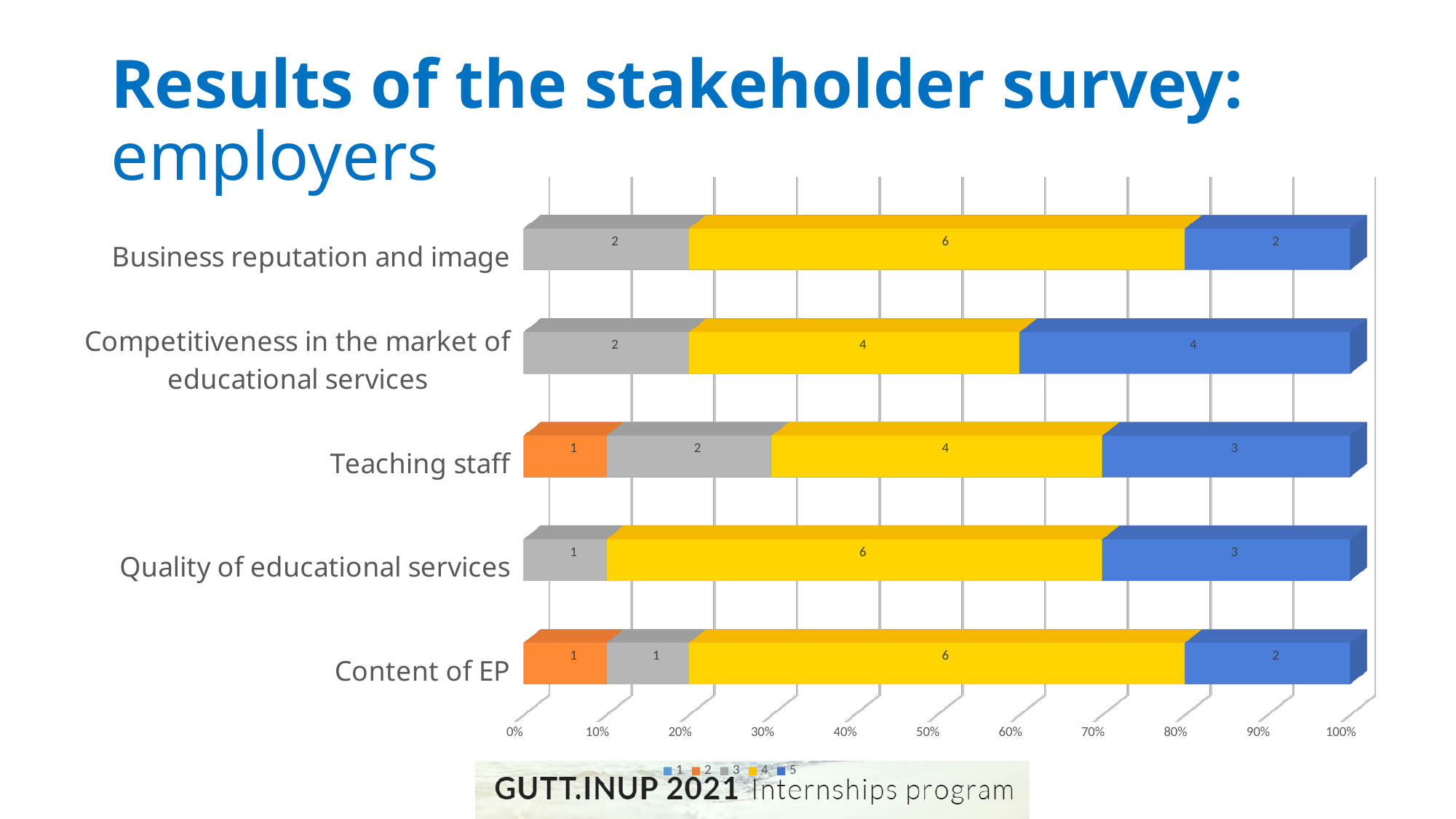
What type of chart is shown on the slide? Stacked bar chart What is the value of series 3 for Quality of educational services? 1 What is the difference between the series 4 value and the series 5 value for Quality of educational services? 3 What is the value of series 2 for Teaching staff? 1 Which categories have a non-zero value for series 2? Teaching staff and Content of EP What is the total of all segments in the Teaching staff bar? 10 What is the value of series 5 for Competitiveness in the market of educational services? 4 How many series does the legend list? 5 What is the value of series 5 for Content of EP? 2 What is the value of series 4 for Business reputation and image? 6 Which is larger for Competitiveness in the market of educational services: the series 3 value or the series 4 value? Series 4 How many categories are shown on the chart? 5